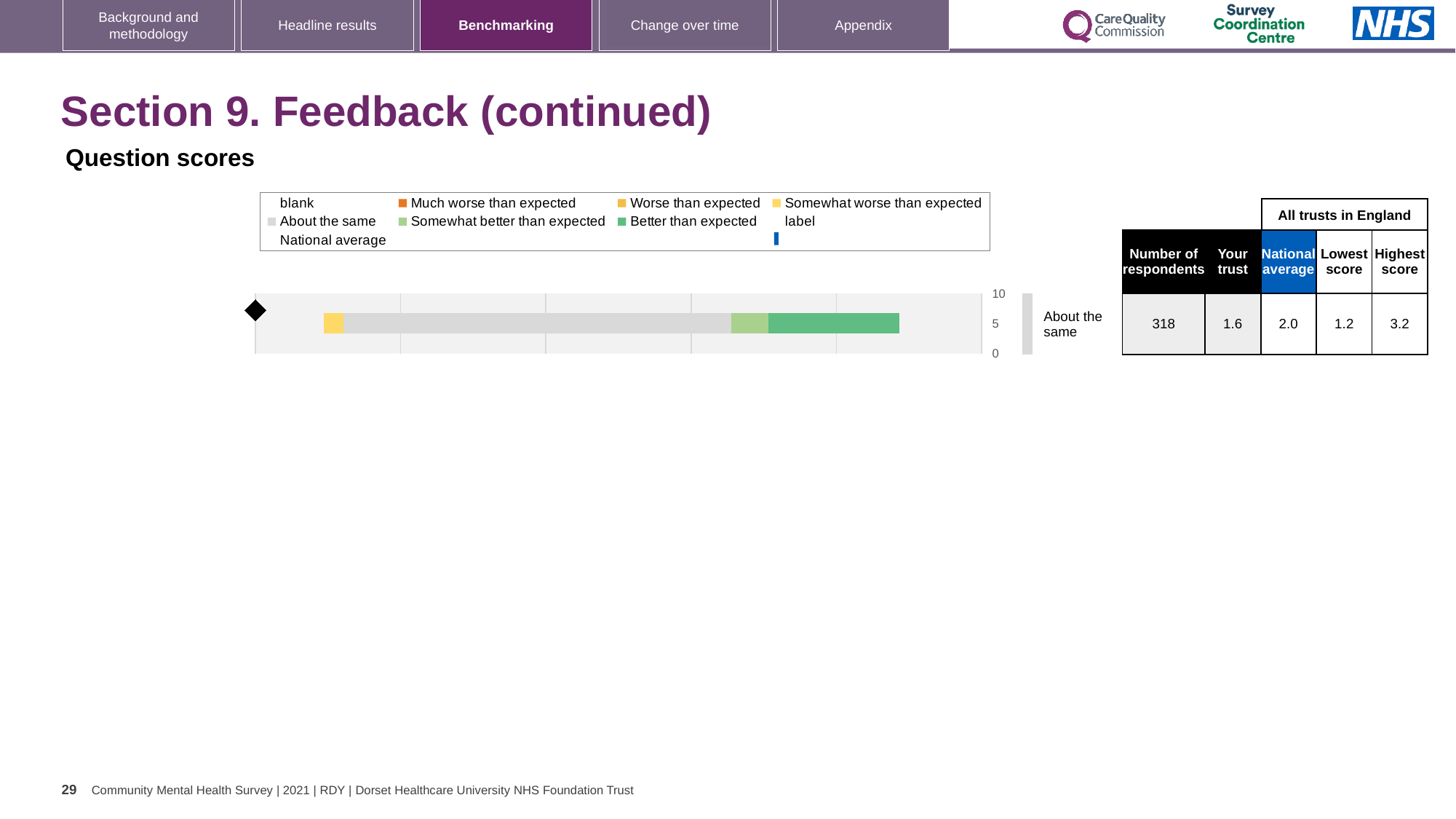
What is the highest score among all trusts in England shown on the slide? 3.2 What is the difference between the national average and the 'Your trust' score? 0.4 What is the lowest score among all trusts in England shown on the slide? 1.2 What benchmark category is the trust's score placed in for this question? About the same What is the title of the chart section on the slide? Question scores What type of chart is shown on the slide? bar chart Which is larger, the 'Your trust' score or the national average? National average What is the difference between the highest score and the lowest score among all trusts in England? 2.0 How many bars are plotted in the chart? 1 What is the 'Your trust' score shown on the slide? 1.6 What is the number of respondents shown for the question on this slide? 318 What is the national average score shown on the slide? 2.0